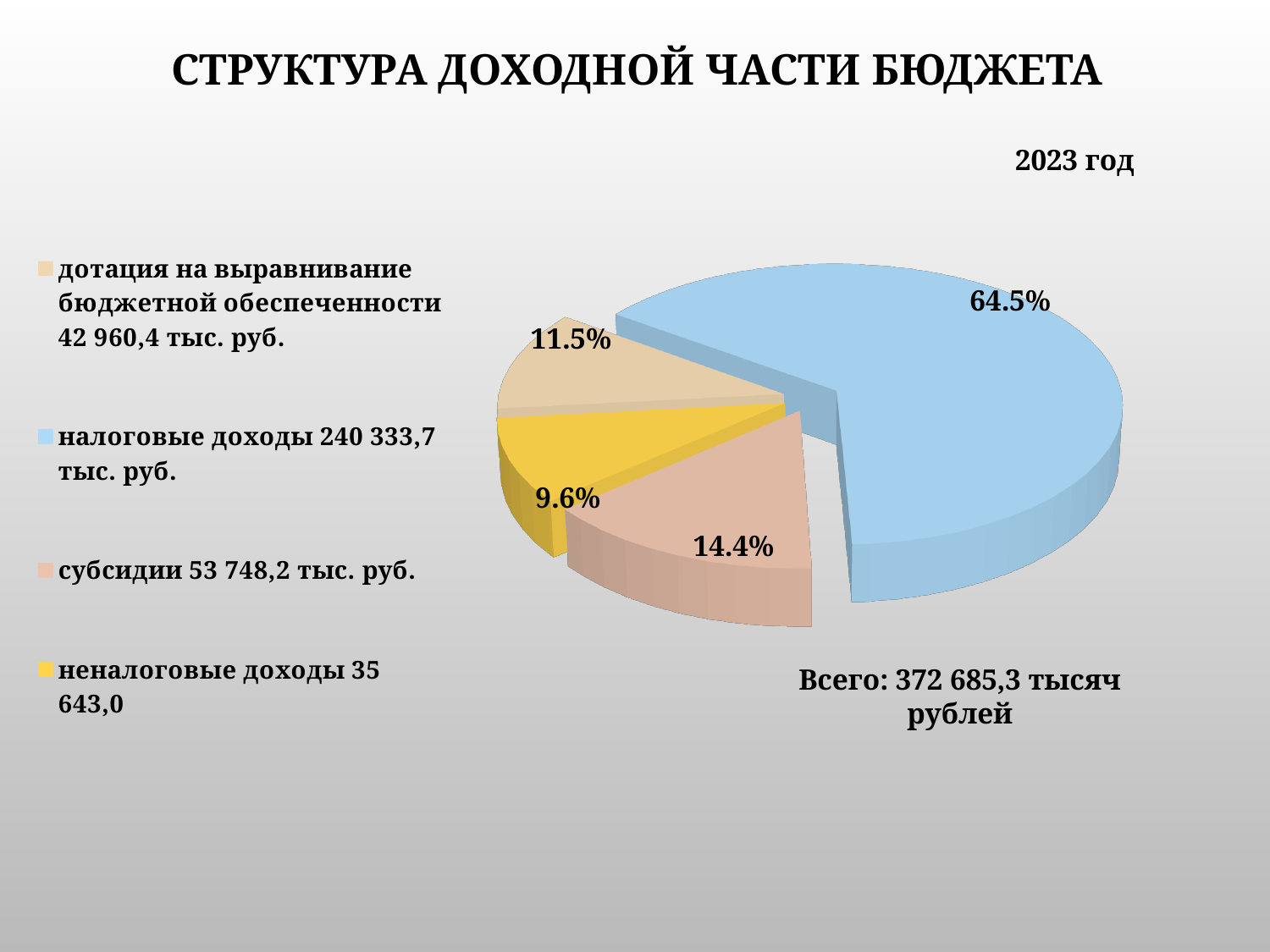
What kind of chart is shown on the slide? pie chart Which is larger: the share for субсидии or the share for дотация на выравнивание бюджетной обеспеченности? субсидии Which category has the smallest slice of the pie? неналоговые доходы What total amount is stated below the pie chart? 372 685,3 тысяч рублей How many slices does the pie chart have? 4 Which category has the largest slice of the pie? налоговые доходы What share of the pie does налоговые доходы take? 64.5% What is the difference in percentage points between the share for налоговые доходы and the share for субсидии? 50.1 What share of the pie does субсидии take? 14.4% What share of the pie does дотация на выравнивание бюджетной обеспеченности take? 11.5% Which year does the chart refer to? 2023 год